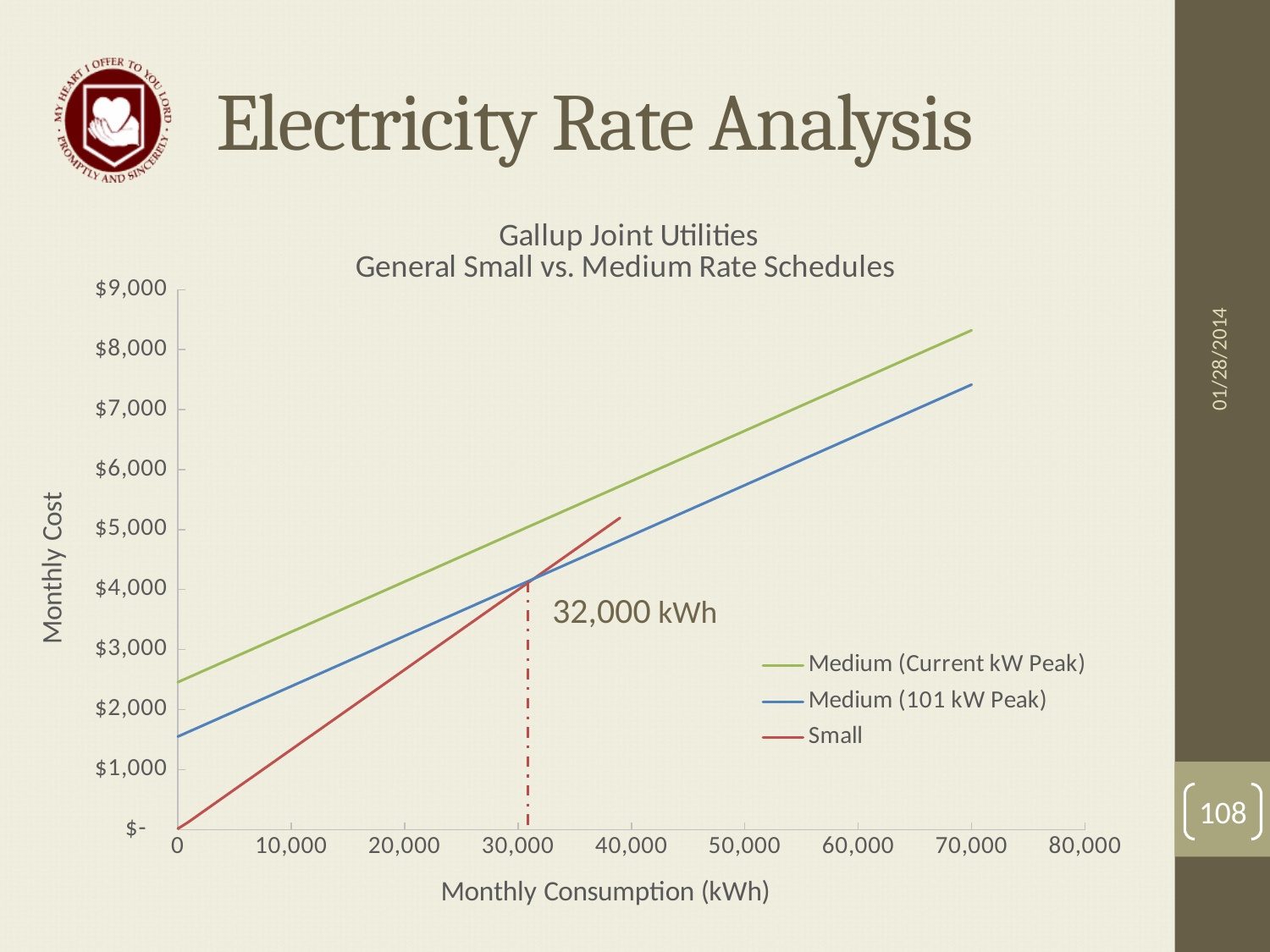
What kind of chart is shown on the slide? line chart At 10,000 kWh, which series has the higher monthly cost, Small or Medium (101 kW Peak)? Medium (101 kW Peak) At 60,000 kWh, which series has the higher monthly cost, Medium (Current kW Peak) or Medium (101 kW Peak)? Medium (Current kW Peak) What consumption level is marked by the dashed vertical line annotation on the chart? 32,000 kWh What is the title of the chart? Gallup Joint Utilities General Small vs. Medium Rate Schedules How many series does the chart's legend list? 3 Which series has the lowest monthly cost at 0 kWh? Small Is the monthly cost for Medium (Current kW Peak) at 70,000 kWh greater or less than $8,000? greater Which series has the highest monthly cost at 0 kWh? Medium (Current kW Peak) Do the monthly cost lines rise or fall as monthly consumption increases? rise Is the monthly cost for Medium (Current kW Peak) at 0 kWh greater or less than $2,000? greater Is the monthly cost for Medium (101 kW Peak) at 0 kWh greater or less than $2,000? less